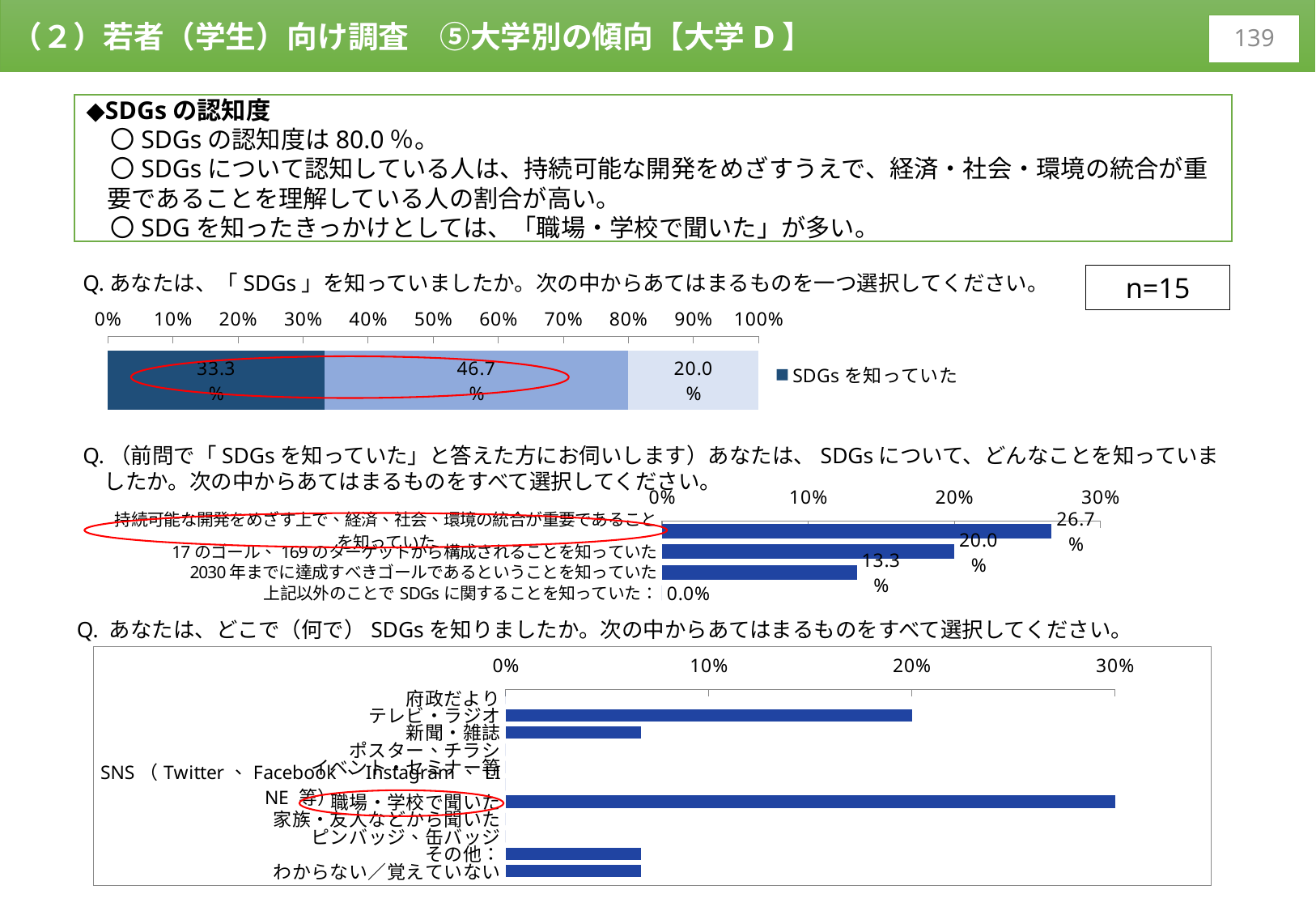
In the middle bar chart, which category has the highest value? 持続可能な開発をめざす上で、経済、社会、環境の統合が重要であることを知っていた In the middle bar chart, what is the value for '2030年までに達成すべきゴールであるということを知っていた'? 13.3% In the top stacked bar chart (SDGs awareness), what is the value of the first (darkest) segment? 33.3% In the middle bar chart, what is the value for '17のゴール、169のターゲットから構成されることを知っていた'? 20.0% In the bottom bar chart, which category has the longest bar? 職場・学校で聞いた What kind of chart is the bottom chart? bar chart In the top stacked bar chart, what is the value of the lightest (rightmost) segment? 20.0% What is the sample size (n) shown next to the top chart? n=15 In the top stacked bar chart, what is the difference between the middle segment (46.7%) and the first segment (33.3%)? 13.4% In the bottom bar chart, is the value for 'テレビ・ラジオ' greater or less than 10%? greater In the top stacked bar chart, what is the value of the middle segment? 46.7% In the middle bar chart, what is the value for '上記以外のことでSDGsに関することを知っていた'? 0.0%